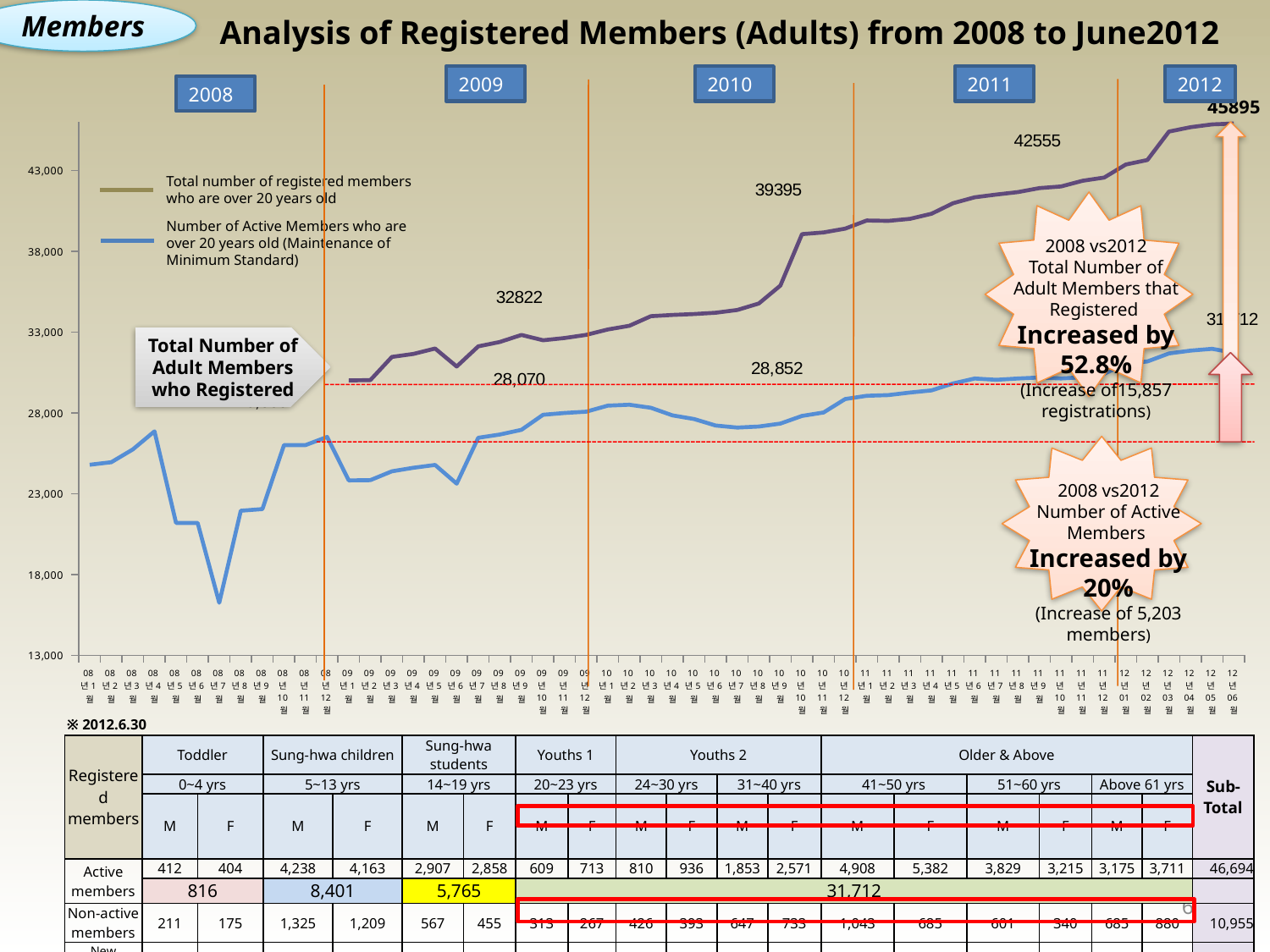
What is the difference between the labeled total registered members values 45895 and 42555? 3340 What kind of chart is shown on the slide? line chart Is the lowest value of the active members line in 2008 greater or less than 18,000? less What value is labeled on the active members line in the 2010 section of the chart? 28,852 What value is labeled on the total registered members line in the 2011 section of the chart? 42555 What value is labeled on the total registered members line in the 2010 section of the chart? 39395 Does the total number of registered members line generally rise or fall from 2008 to 2012? rise What is the final labeled value of the total number of registered members over 20 years old in 2012? 45895 How many series does the chart's legend list? 2 According to the annotation, by what percentage did the total number of adult members that registered increase from 2008 to 2012? 52.8% What value is labeled on the total registered members line in the 2009 section of the chart? 32822 What value is labeled on the active members line in the 2009 section of the chart? 28,070